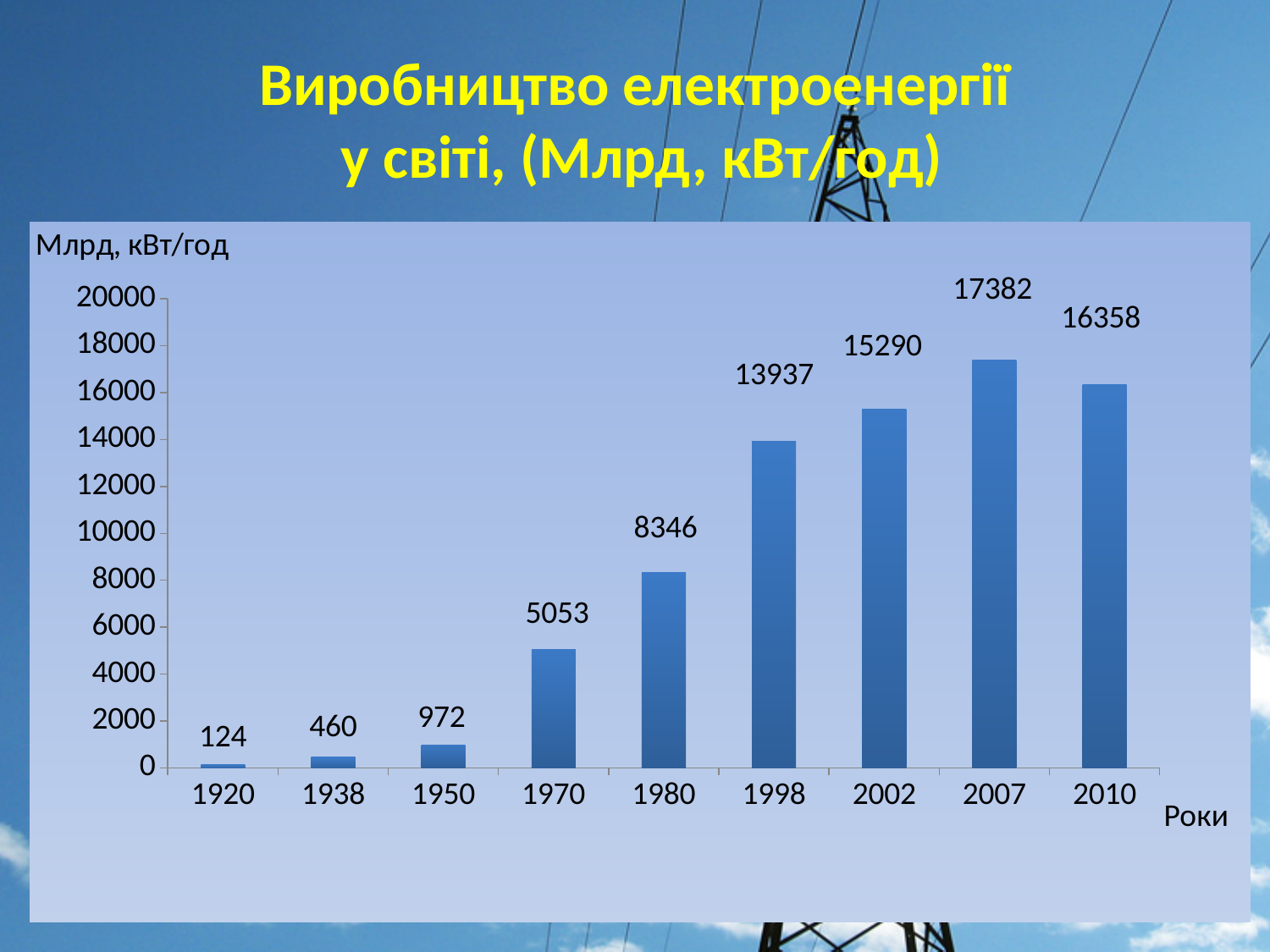
What is the value for 1970? 5053 Which year has the lowest value? 1920 What is the difference between the values for 2007 and 2010? 1024 What kind of chart is shown on the slide? bar chart Which is larger, the value for 1998 or the value for 2002? 2002 What is the difference between the values for 1980 and 1970? 3293 Is the value for 1980 greater or less than 10000? less What is the value for 2002? 15290 What is the value for 1920? 124 What is the label on the x axis? Роки How many years are shown on the x axis? 9 Which year has the highest value? 2007